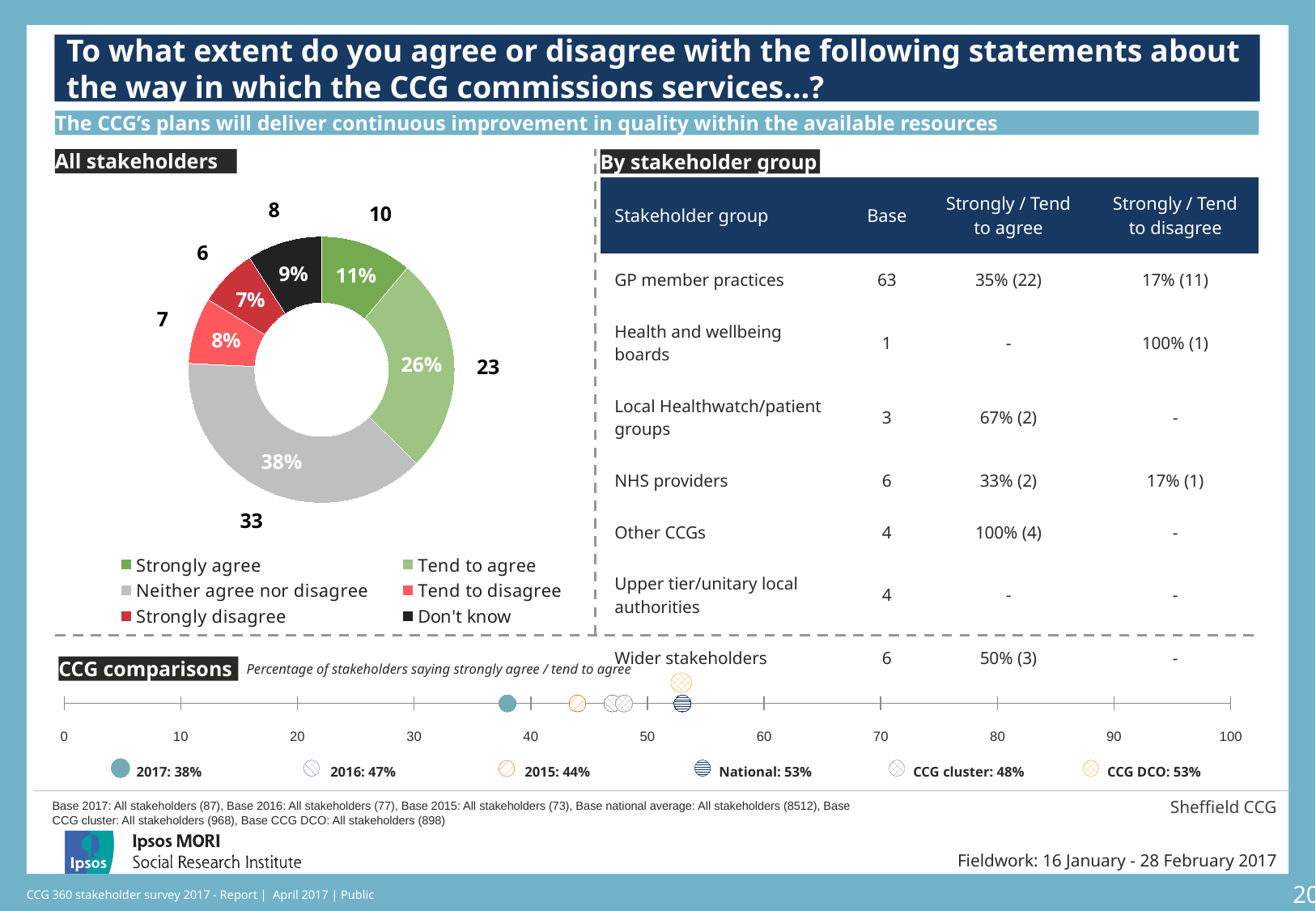
In the All stakeholders chart, what percentage of stakeholders said 'Strongly agree'? 11% In the CCG comparisons chart, what is the 2017 percentage of stakeholders saying strongly agree / tend to agree? 38% In the All stakeholders chart, what percentage of stakeholders said 'Neither agree nor disagree'? 38% In the All stakeholders chart, how many stakeholders said 'Tend to agree'? 23 What kind of chart is the All stakeholders chart? Donut (pie) chart How many response categories does the legend of the All stakeholders chart list? 6 In the All stakeholders chart, which response category has the smallest share? Strongly disagree In the All stakeholders chart, which response category has the largest share? Neither agree nor disagree In the CCG comparisons chart, what is the difference in percentage points between the National value and the 2017 value? 15 In the All stakeholders chart, what is the difference in percentage points between 'Tend to agree' and 'Tend to disagree'? 18 In the All stakeholders chart, which is larger: the share for 'Don't know' or the share for 'Tend to disagree'? Don't know